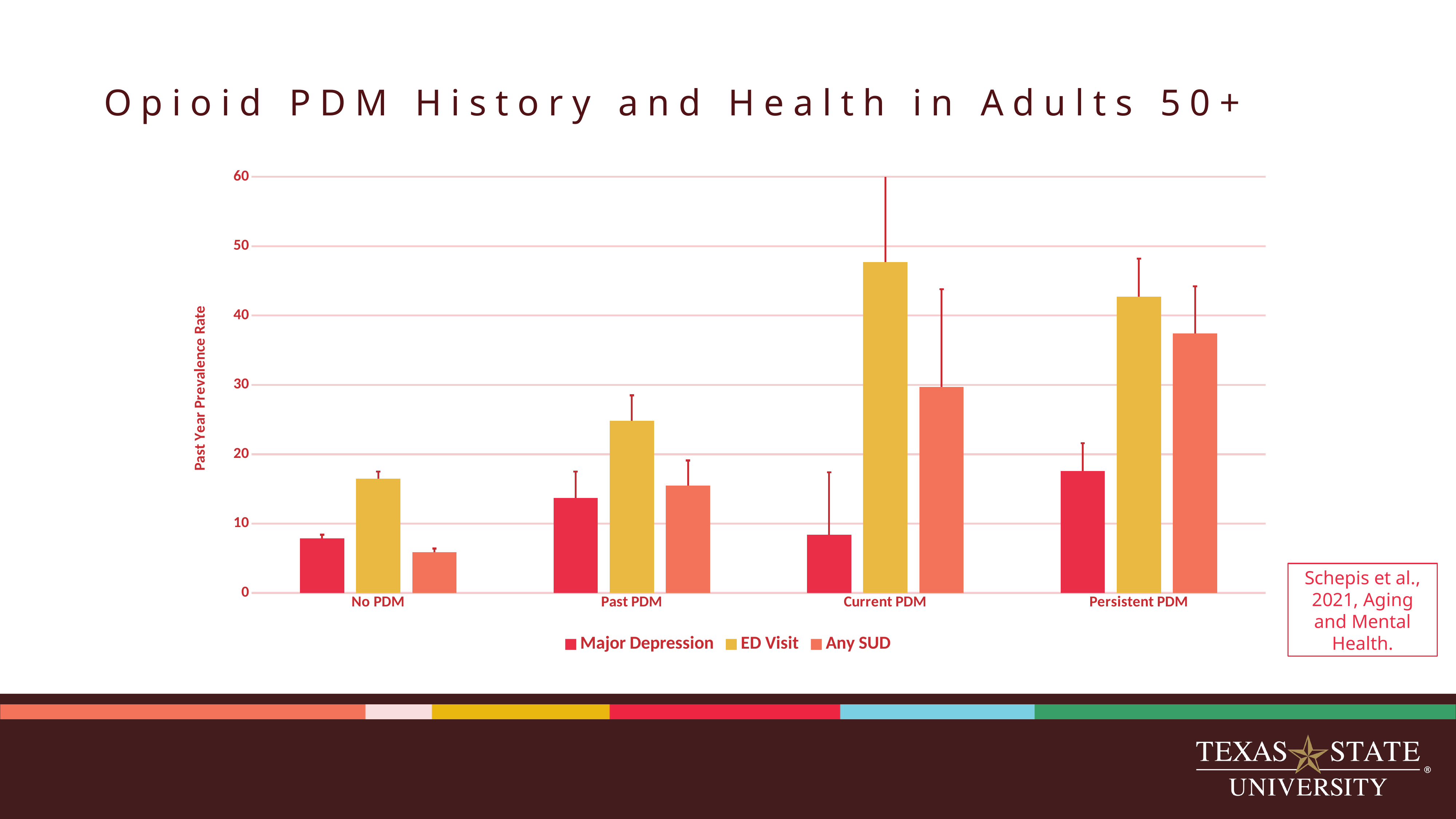
Is the Any SUD value for No PDM greater or less than 10? less How many PDM history categories are shown on the x axis? 4 What is the label of the y axis? Past Year Prevalence Rate Which category has the lowest Any SUD prevalence rate? No PDM Is the ED Visit value for Past PDM greater or less than 20? greater For Current PDM, which is larger: Major Depression or Any SUD? Any SUD For Persistent PDM, which is larger: ED Visit or Any SUD? ED Visit Is the ED Visit value for Current PDM greater or less than 40? greater How many series does the legend list? 3 Which category has the highest ED Visit prevalence rate? Current PDM What kind of chart is shown on the slide? Bar chart Which category has the highest Major Depression prevalence rate? Persistent PDM